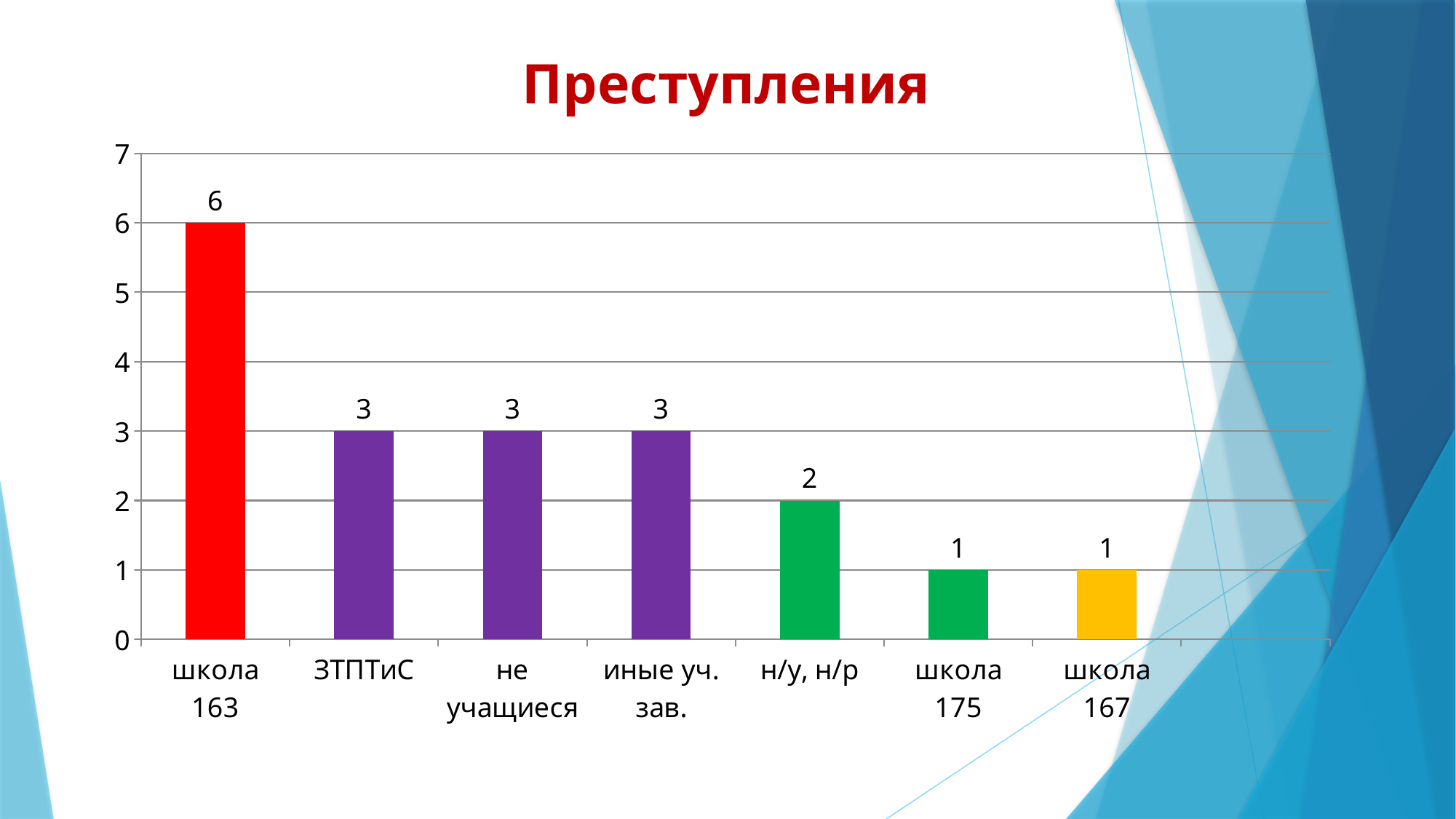
How many categories are shown on the x axis? 7 Which is larger, the value for иные уч. зав. or the value for н/у, н/р? иные уч. зав. What is the value for школа 163? 6 What kind of chart is shown on the slide? bar chart What is the title of the slide? Преступления Is the value for школа 163 greater or less than 5? greater Which category has the highest value? школа 163 What is the difference between the values for н/у, н/р and школа 175? 1 What is the value for ЗТПТиС? 3 What is the difference between the values for школа 163 and не учащиеся? 3 What is the value for н/у, н/р? 2 What is the value for школа 167? 1